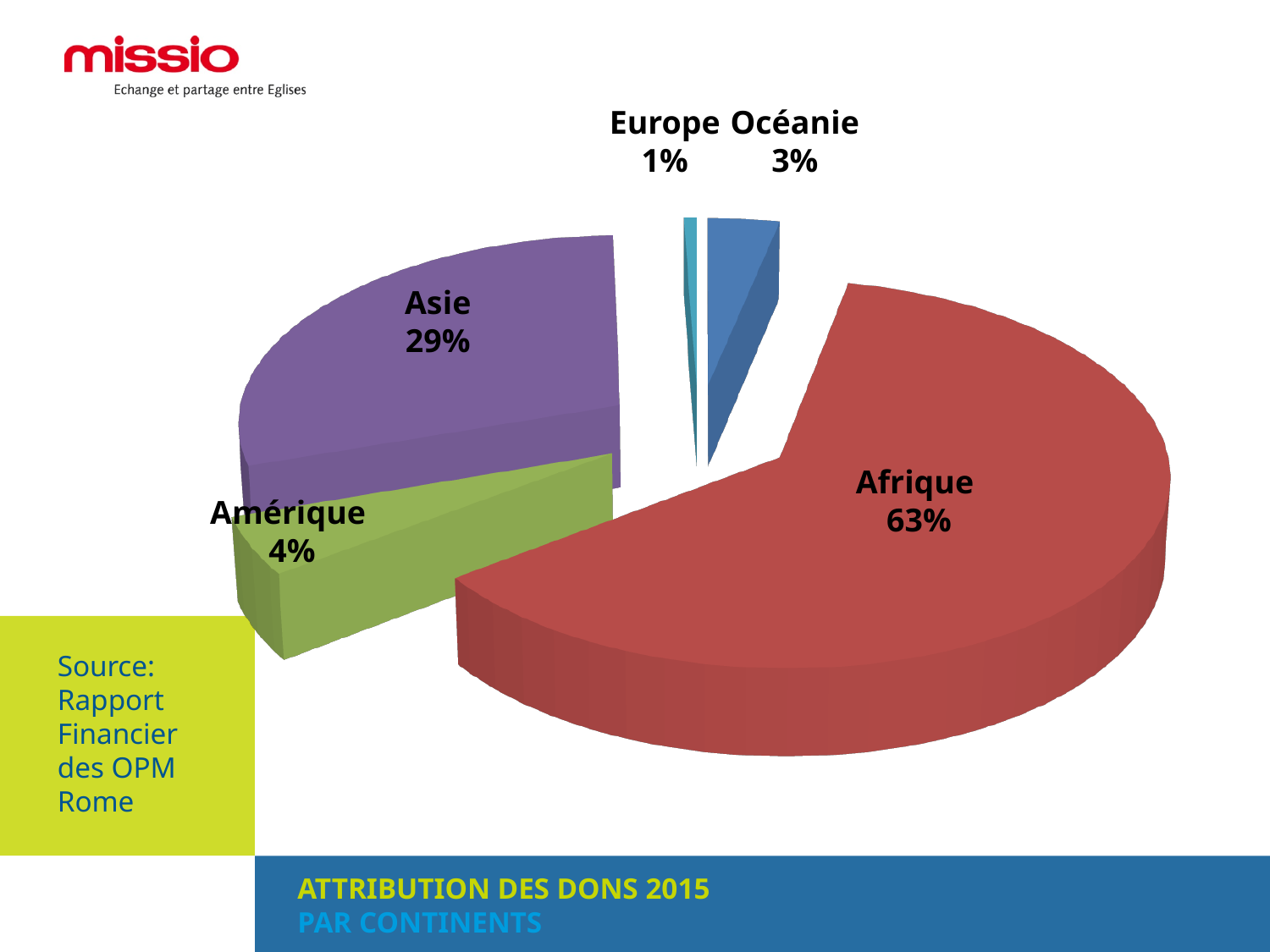
What kind of chart is shown on the slide? Pie chart What is the difference in percentage points between the shares for Afrique and Asie? 34 Which has a larger share, Amérique or Océanie? Amérique Which continent receives the smallest share of the donations? Europe What colour is the slice for Asie? Purple What share of the donations is attributed to Asie? 29% Which continent receives the largest share of the donations? Afrique What share of the donations is attributed to Océanie? 3% What share of the donations is attributed to Afrique? 63% How many continents are shown in the pie chart? 5 What share of the donations is attributed to Amérique? 4% What share of the donations is attributed to Europe? 1%